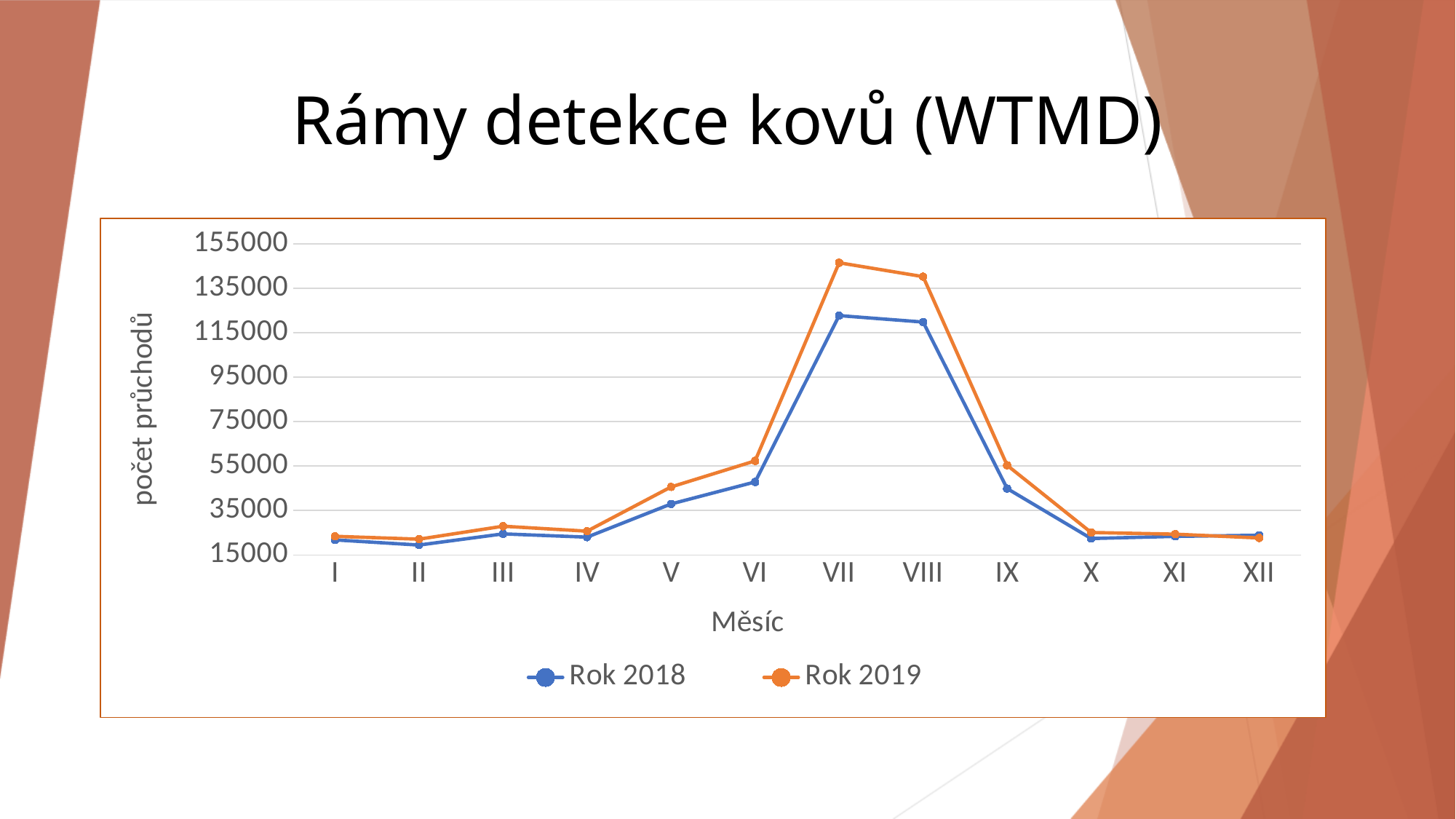
What is the title of the x axis? Měsíc How many months are plotted along the x axis? 12 What kind of chart is shown on the slide? line chart In which month does the Rok 2019 series reach its highest value? VII In which month is the Rok 2018 series at its lowest? II Is the Rok 2019 value for month VII greater or less than 135000? greater How many series does the legend list? 2 In which month does the Rok 2018 series reach its highest value? VII Is the Rok 2019 value for month IX greater or less than 75000? less Is the Rok 2018 value for month VII greater or less than 135000? less In month VII, which series has the larger value, Rok 2018 or Rok 2019? Rok 2019 Do the values of the Rok 2019 series rise or fall from month VIII to month X? fall